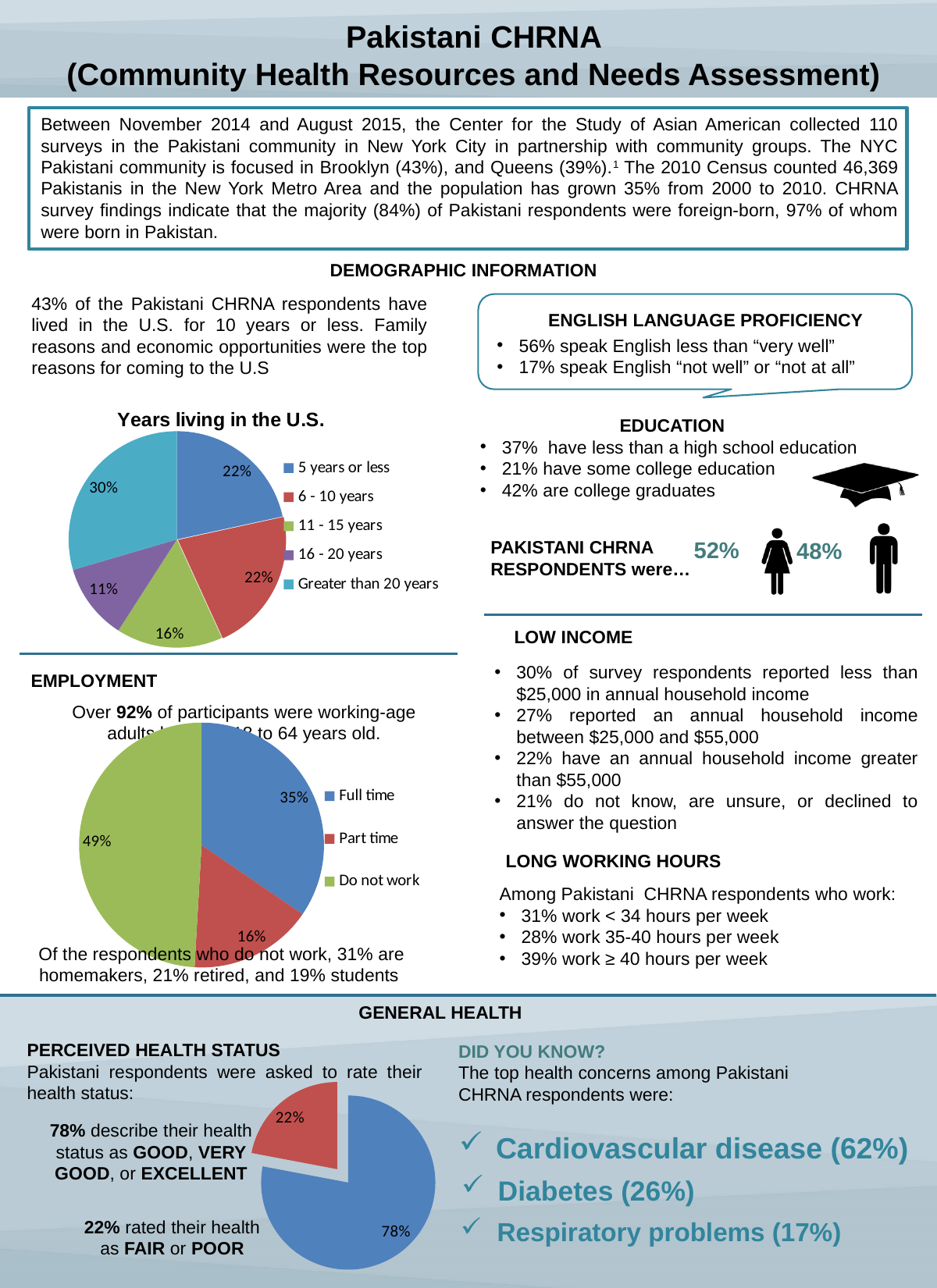
In the Employment pie chart, what is the difference between the share who do not work and the share who work part time? 33 percentage points How many categories does the legend of the "Years living in the U.S." pie chart list? 5 In the "Years living in the U.S." pie chart, which category has the largest share? Greater than 20 years In the Perceived Health Status pie chart, what share of respondents rated their health as fair or poor? 22% In the "Years living in the U.S." pie chart, what share of respondents have lived in the U.S. for greater than 20 years? 30% In the "Years living in the U.S." pie chart, which category has the smallest share? 16 - 20 years In the Employment pie chart, which category has the largest share? Do not work In the Employment pie chart, is the share for full time or part time larger? Full time In the "Years living in the U.S." pie chart, what share of respondents have lived in the U.S. for 11 - 15 years? 16% In the Employment pie chart, what share of respondents work full time? 35% What kind of chart is used in the Employment section? Pie chart In the "Years living in the U.S." pie chart, what is the difference between the share for greater than 20 years and the share for 16 - 20 years? 19 percentage points